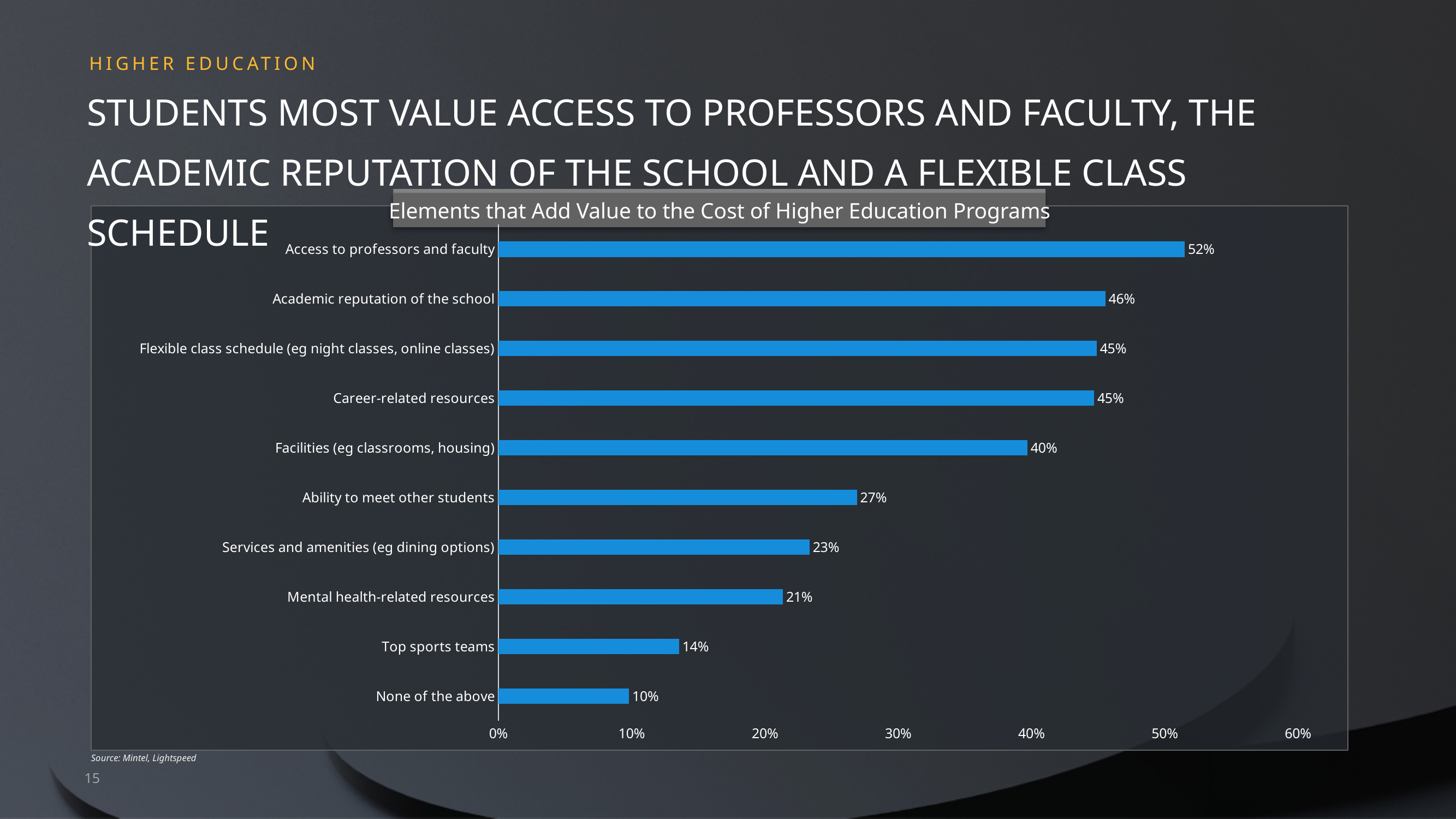
Which category has the lowest value? None of the above Is the value for Facilities (eg classrooms, housing) greater or less than 30%? greater What is the difference between Ability to meet other students and Top sports teams? 13% What is the title of the chart? Elements that Add Value to the Cost of Higher Education Programs What is the value for Mental health-related resources? 21% Which category has the highest value? Access to professors and faculty Which is larger, Services and amenities (eg dining options) or Mental health-related resources? Services and amenities (eg dining options) What kind of chart is shown on the slide? bar chart What is the value for Facilities (eg classrooms, housing)? 40% How many categories are shown in the chart? 10 What is the value for Access to professors and faculty? 52% What is the difference between Access to professors and faculty and Academic reputation of the school? 6%